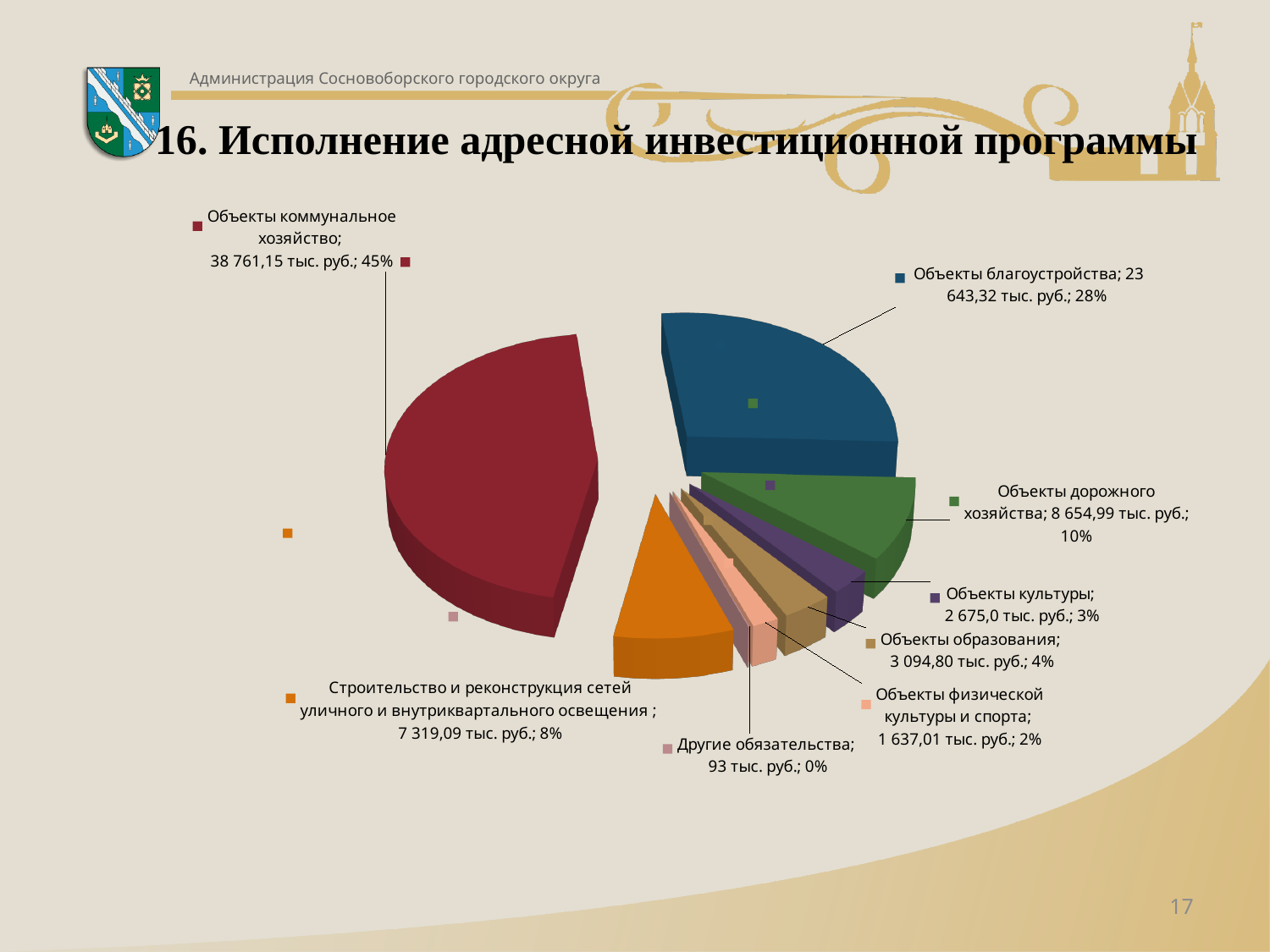
What share of the pie does Строительство и реконструкция сетей уличного и внутриквартального освещения represent? 8% What is the value for Объекты благоустройства? 23 643,32 тыс. руб. What is the value for Объекты дорожного хозяйства? 8 654,99 тыс. руб. What share of the pie does Объекты благоустройства represent? 28% Which category has the largest slice of the pie? Объекты коммунальное хозяйство What is the value for Другие обязательства? 93 тыс. руб. How many slices does the pie chart have? 8 Which is larger: Объекты образования or Объекты культуры? Объекты образования Which category has the smallest slice of the pie? Другие обязательства What kind of chart is shown on the slide? Pie chart What is the title of the slide containing the chart? 16. Исполнение адресной инвестиционной программы What is the value for Объекты коммунальное хозяйство? 38 761,15 тыс. руб.